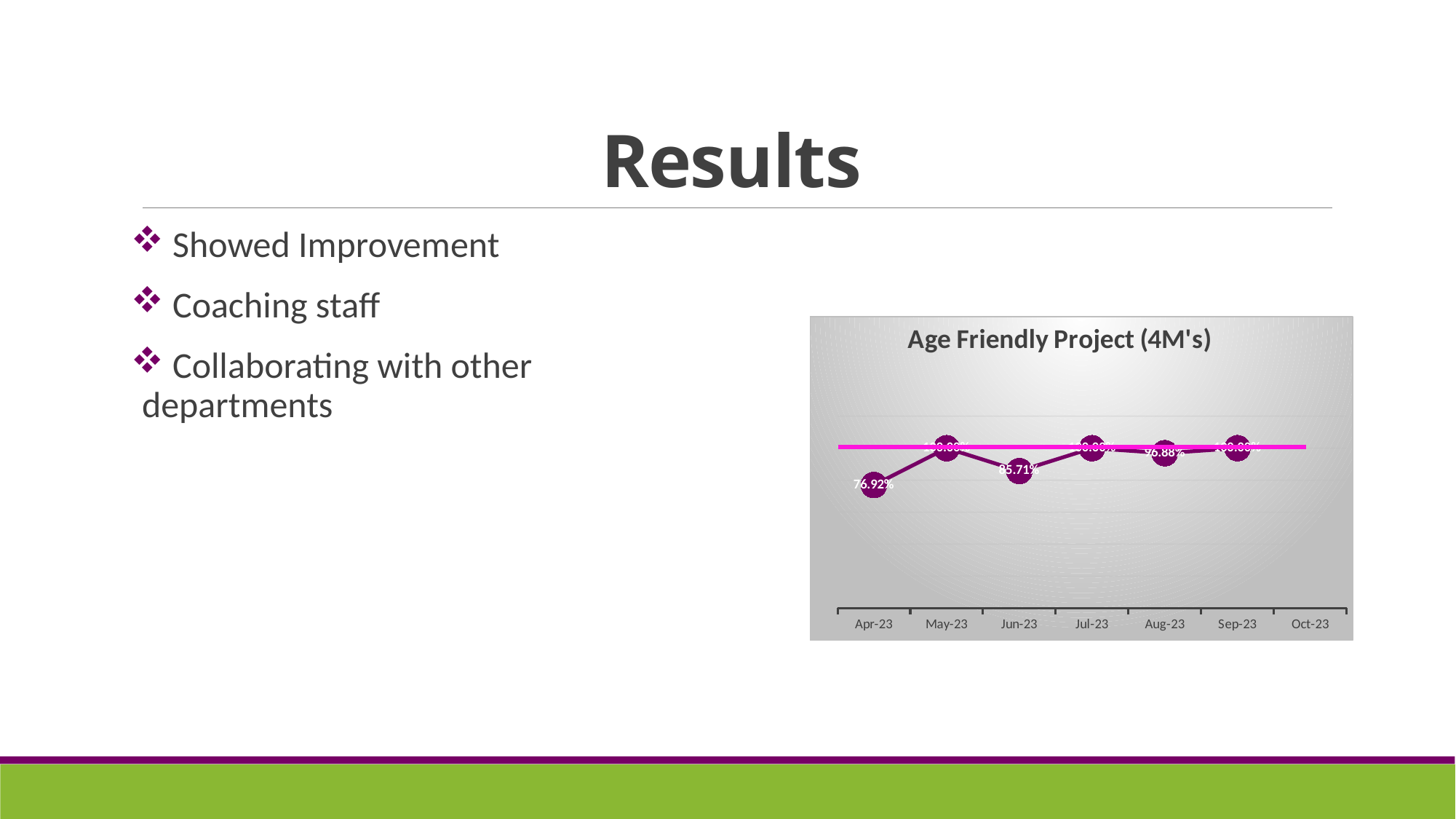
What is the difference between the values for Jun-23 and Apr-23? 8.79% What is the value for Aug-23 in the Age Friendly Project chart? 96.88% Which is larger, the value for Apr-23 or the value for Jun-23? Jun-23 What is the difference between the values for Aug-23 and Jun-23? 11.17% How many month labels are shown on the x axis of the chart? 7 What is the title of the chart? Age Friendly Project (4M's) What type of chart is shown on the slide? Line chart Which is larger, the value for Jun-23 or the value for Aug-23? Aug-23 How many data points are plotted on the line in the chart? 6 What is the value for Jun-23 in the Age Friendly Project chart? 85.71% Which month has the lowest value in the Age Friendly Project chart? Apr-23 What is the value for Apr-23 in the Age Friendly Project chart? 76.92%